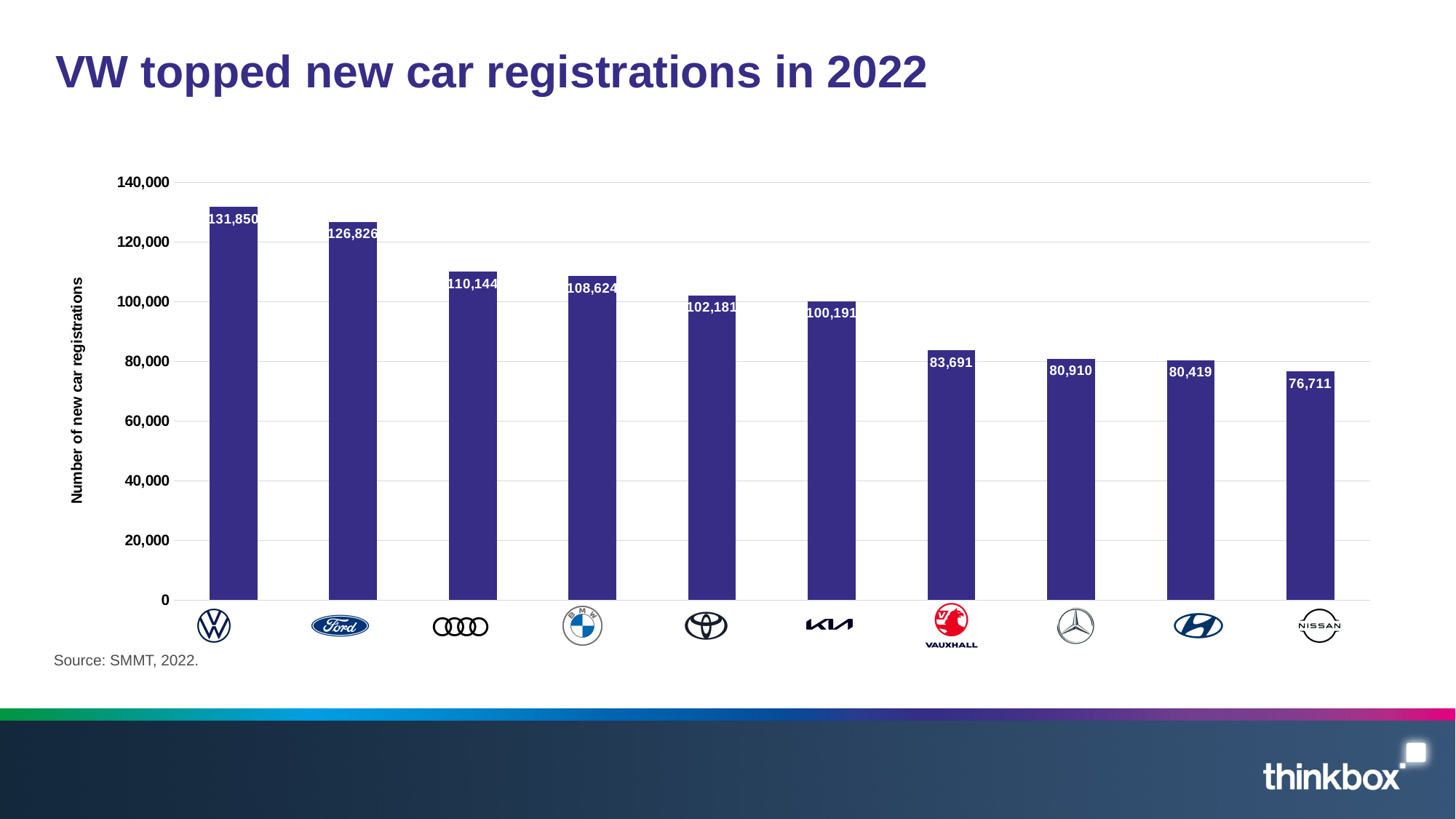
Which brand has the lowest number of new car registrations? Nissan What type of chart is shown on the slide? Bar chart Which has more new car registrations, Audi or Toyota? Audi What is the number of new car registrations for Ford? 126,826 How many brands are shown in the chart? 10 Which brand has the highest number of new car registrations? VW What is the number of new car registrations for BMW? 108,624 What is the number of new car registrations for Nissan? 76,711 What is the difference in new car registrations between VW and Nissan? 55,139 What is the number of new car registrations for Vauxhall? 83,691 What is the difference in new car registrations between VW and Ford? 5,024 What is the title of the slide? VW topped new car registrations in 2022